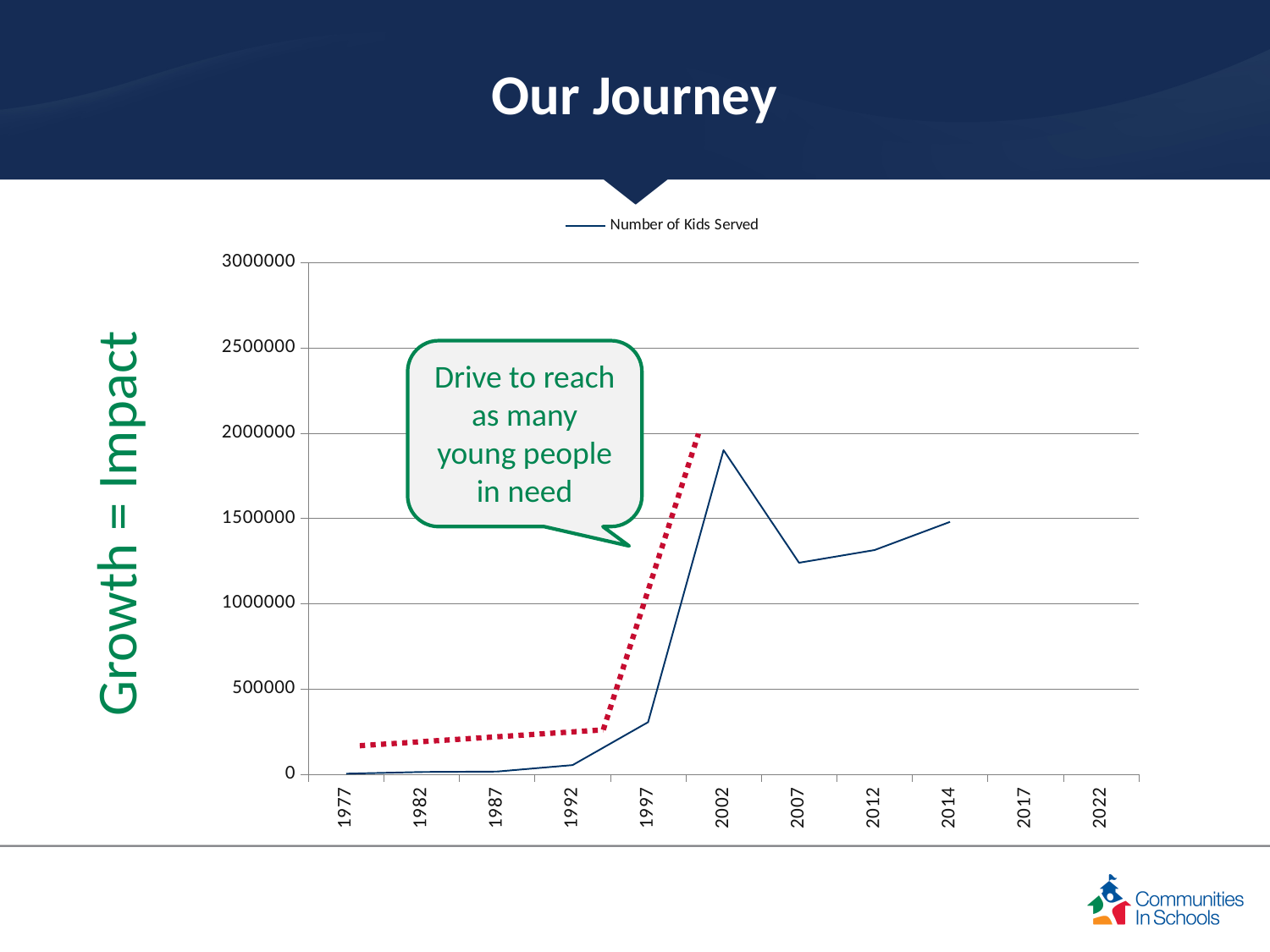
Does the Number of Kids Served rise or fall between 2002 and 2007? fall How many year labels are shown on the x axis? 11 Which year has a larger Number of Kids Served, 2002 or 2007? 2002 Which year has a larger Number of Kids Served, 2012 or 2014? 2014 What is the name of the series shown in the legend? Number of Kids Served Is the Number of Kids Served in 2002 greater or less than 1500000? greater How many series does the legend list? 1 Is the Number of Kids Served in 1997 greater or less than 500000? less In which year is the Number of Kids Served lowest? 1977 Is the Number of Kids Served in 2007 greater or less than 1500000? less In which year is the Number of Kids Served highest? 2002 What kind of chart is shown on the slide? line chart